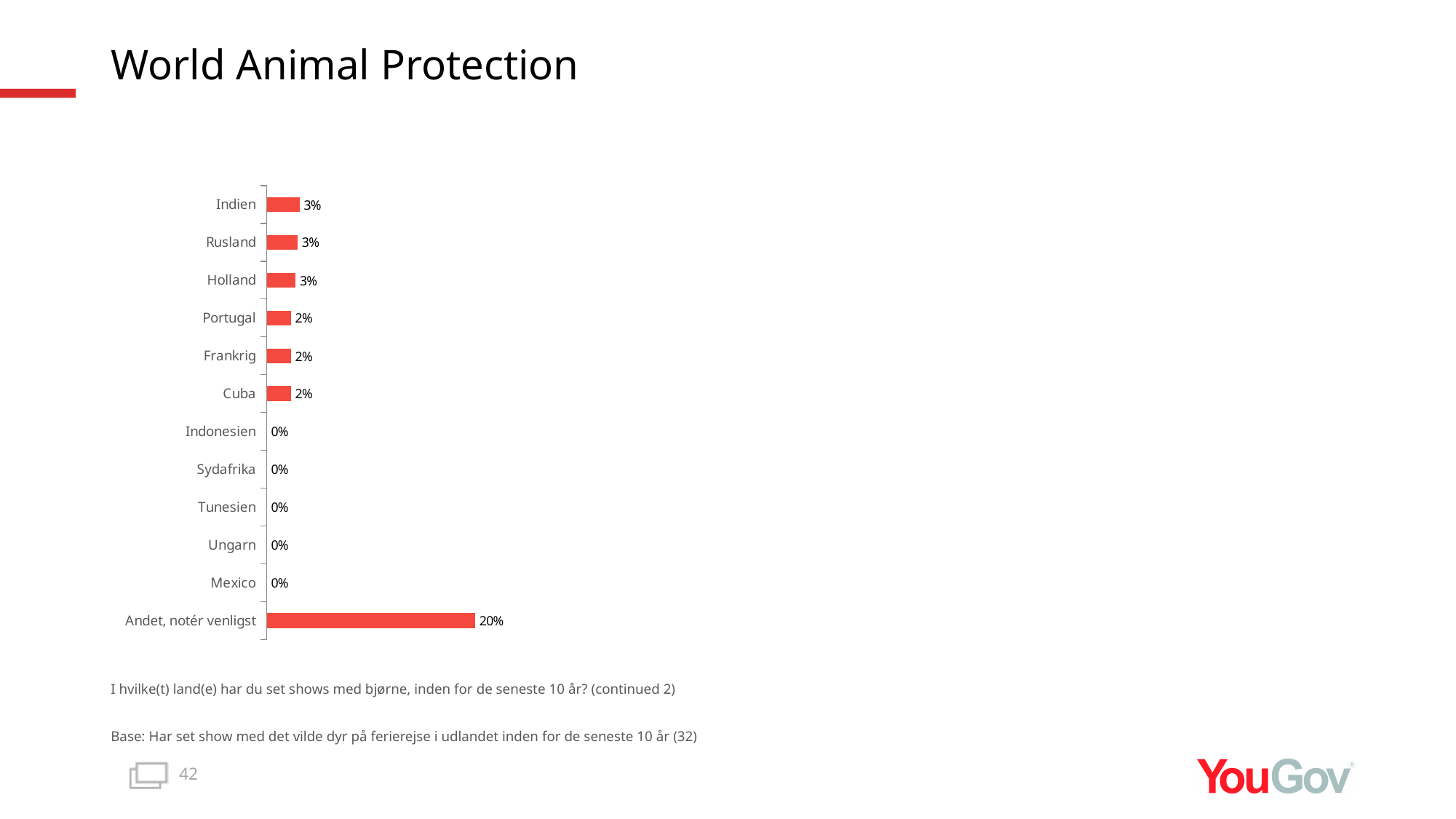
What kind of chart is shown on the slide? Bar chart What is the value for Mexico? 0% What is the value for Indien? 3% How many categories are shown on the chart? 12 How many categories have a value of 0%? 5 What is the value for "Andet, notér venligst"? 20% What is the value for Portugal? 2% Which category has the highest value? Andet, notér venligst What is the difference between the values for "Andet, notér venligst" and Holland? 17% Which is larger, the value for Frankrig or the value for Indien? Indien What colour are the bars in the chart? Red What is the difference between the values for Rusland and Cuba? 1%